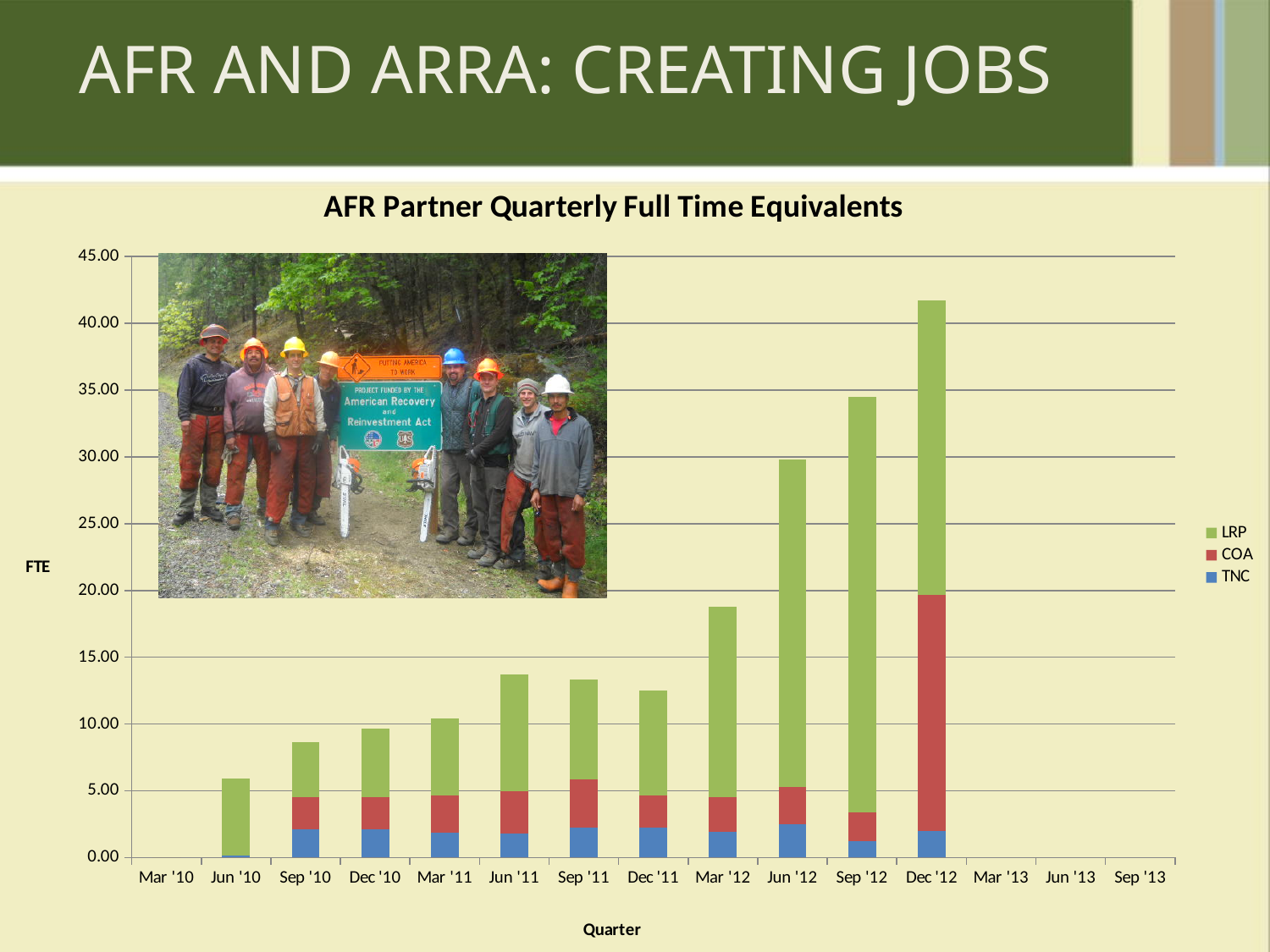
What is the title of the chart? AFR Partner Quarterly Full Time Equivalents Do the total FTE values rise or fall from Mar '12 to Dec '12? Rise How many series does the legend list? 3 Is the total FTE for Jun '10 greater or less than 5.00? greater Among the quarters with a visible bar, which has the shortest stacked bar? Jun '10 What kind of chart is shown on the slide? Stacked bar chart Which quarter has a larger total FTE, Dec '12 or Sep '12? Dec '12 Is the total FTE for Sep '10 greater or less than 10.00? less Is the total FTE for Mar '12 greater or less than 20.00? less Which quarter has the tallest stacked bar? Dec '12 Which quarter has a larger total FTE, Mar '12 or Dec '11? Mar '12